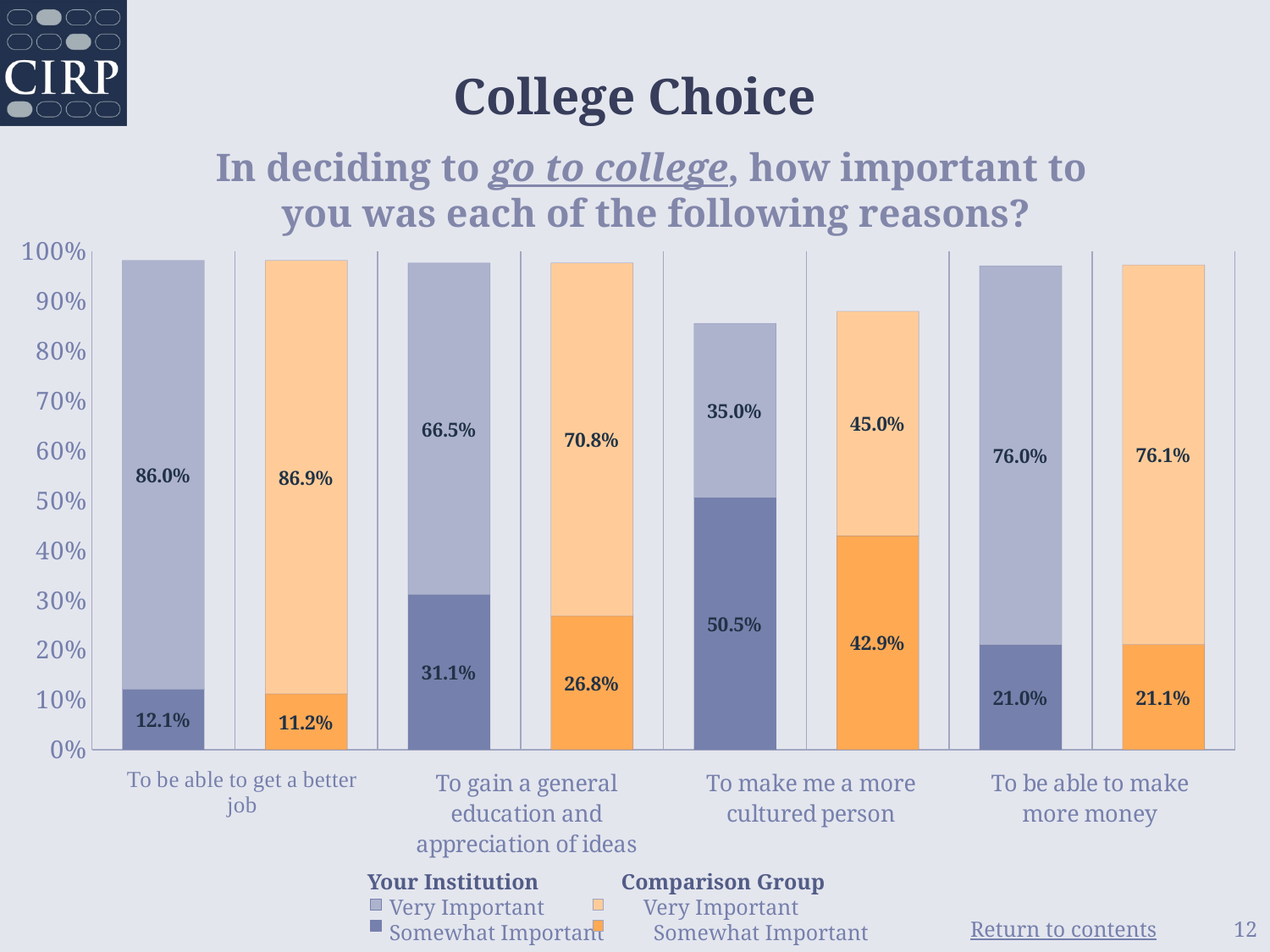
What kind of chart is shown on the slide? Stacked bar chart For 'To gain a general education and appreciation of ideas', which group has the larger Very Important percentage, Your Institution or the Comparison Group? Comparison Group What is the difference between the Comparison Group and Your Institution Very Important percentages for 'To make me a more cultured person'? 10.0% What percentage of Your Institution respondents rated 'To be able to get a better job' as Very Important? 86.0% What is the total of the Comparison Group stacked bar for 'To be able to make more money'? 97.2% How many series does the legend list? 4 Which reason has the highest Very Important percentage for Your Institution? To be able to get a better job What is the total of the Your Institution stacked bar for 'To make me a more cultured person'? 85.5% Which reason has the lowest Very Important percentage for the Comparison Group? To make me a more cultured person How many reasons (categories) are shown on the x axis? 4 What percentage of Your Institution respondents rated 'To gain a general education and appreciation of ideas' as Somewhat Important? 31.1% What percentage of the Comparison Group rated 'To make me a more cultured person' as Somewhat Important? 42.9%